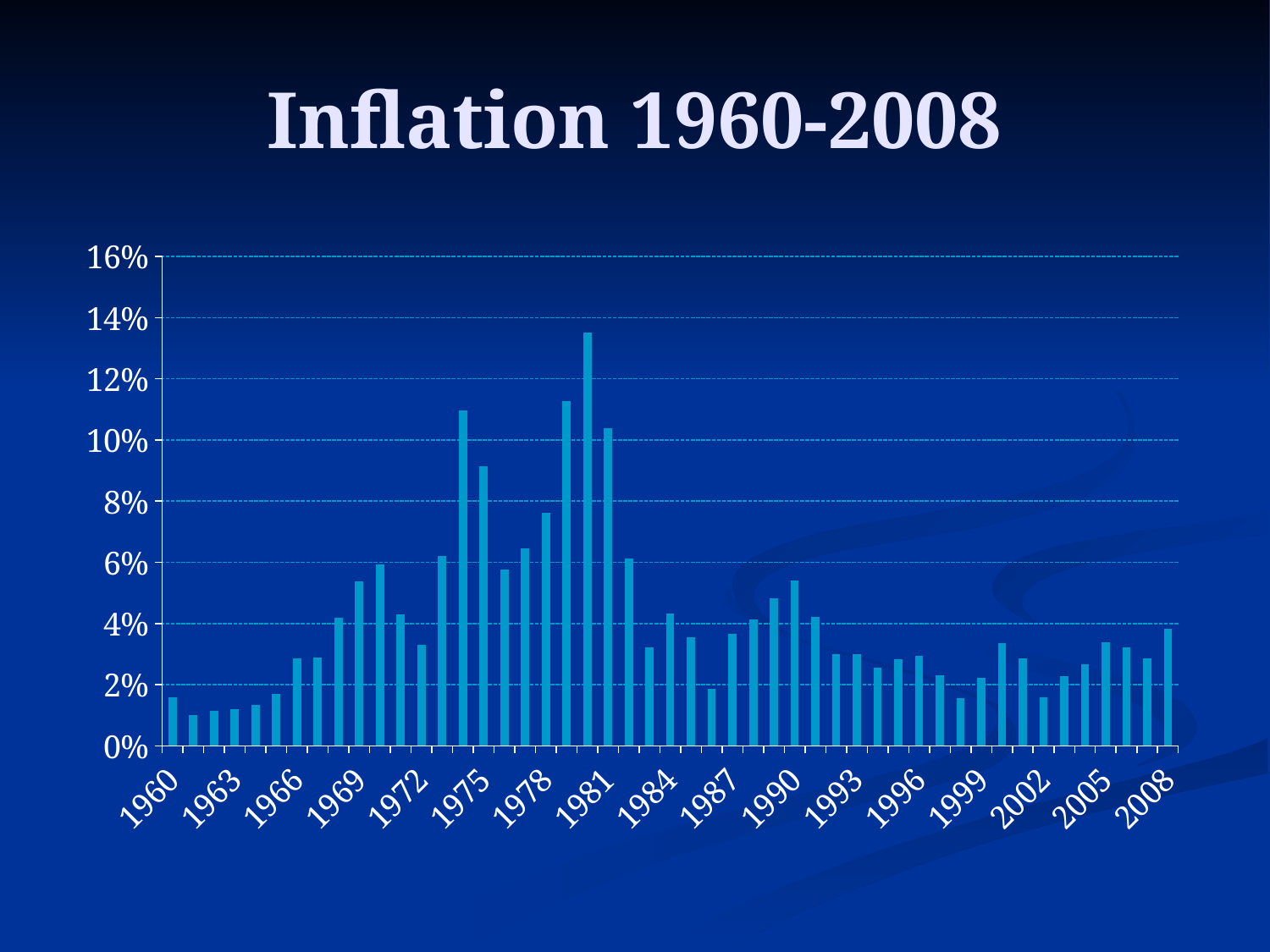
Is the inflation value for 2002 greater or less than 2%? less Is the tallest bar on the chart greater or less than 12%? greater Is the inflation value for 1993 greater or less than 4%? less What is the title of the chart? Inflation 1960-2008 What is the highest value shown on the vertical axis? 16% What kind of chart is shown on the slide? bar chart Which year has the higher inflation value, 1963 or 1969? 1969 Which year has the higher inflation value, 1975 or 1978? 1975